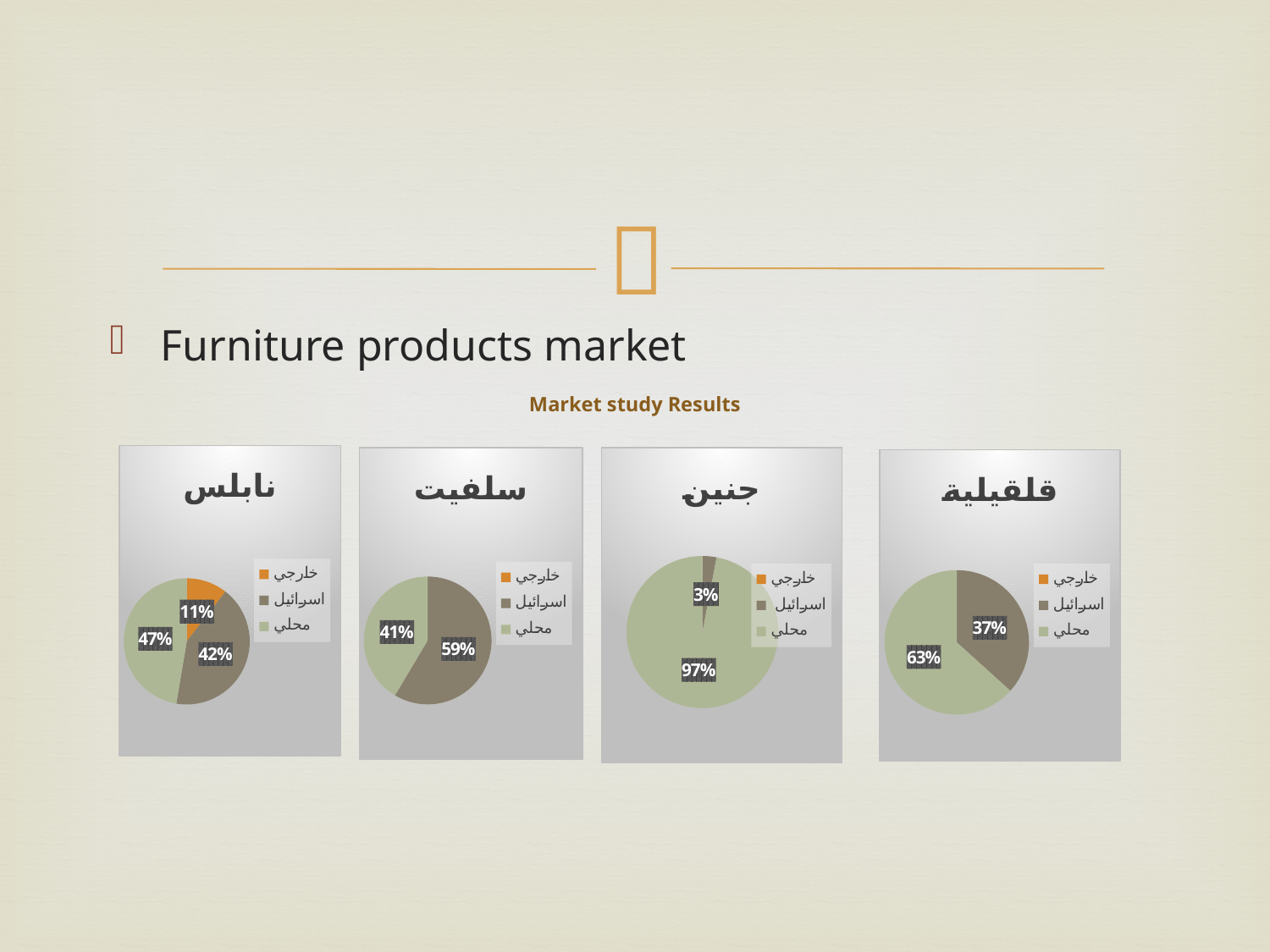
In the جنين chart (third from left), which slice is the largest? محلي What type of charts are shown on the slide? Pie charts In the سلفيت chart (second from left), what is the difference between the اسرائيل and محلي slices? 18% In the نابلس chart (leftmost), what is the share of the محلي slice? 47% In the جنين chart (third from left), what is the share of the محلي slice? 97% In the قلقيلية chart (rightmost), which is larger, the محلي slice or the اسرائيل slice? محلي How many charts are on the slide? 4 How many entries does the legend of each chart list? 3 In the قلقيلية chart (rightmost), what is the share of the اسرائيل slice? 37% In the نابلس chart (leftmost), what is the share of the خارجي slice? 11% In the نابلس chart (leftmost), which slice is the smallest? خارجي In the سلفيت chart (second from left), what is the share of the اسرائيل slice? 59%